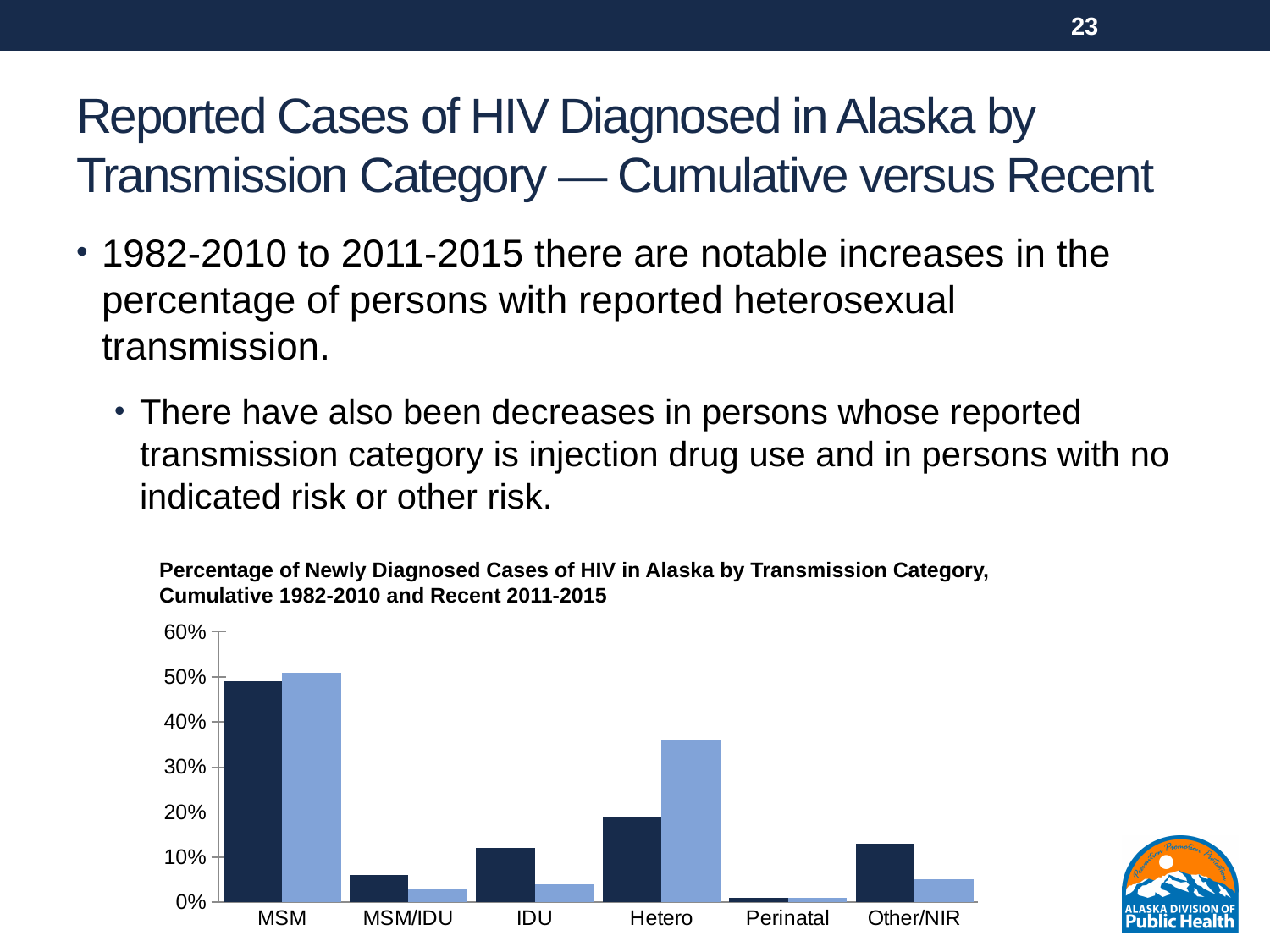
For the IDU category, which bar is taller, the dark blue or the light blue? dark blue What is the highest value shown on the chart's y axis? 60% For the Hetero category, which bar is taller, the dark blue or the light blue? light blue Is the light blue bar for MSM greater or less than 40%? greater Is the dark blue bar for IDU greater or less than 10%? greater Is the dark blue bar for Hetero greater or less than 30%? less Which transmission category has the shortest dark blue bar? Perinatal Which transmission category has the tallest dark blue bar? MSM What kind of chart is shown on the slide? bar chart How many transmission categories are shown on the x axis of the chart? 6 Which transmission category has the tallest light blue bar? MSM